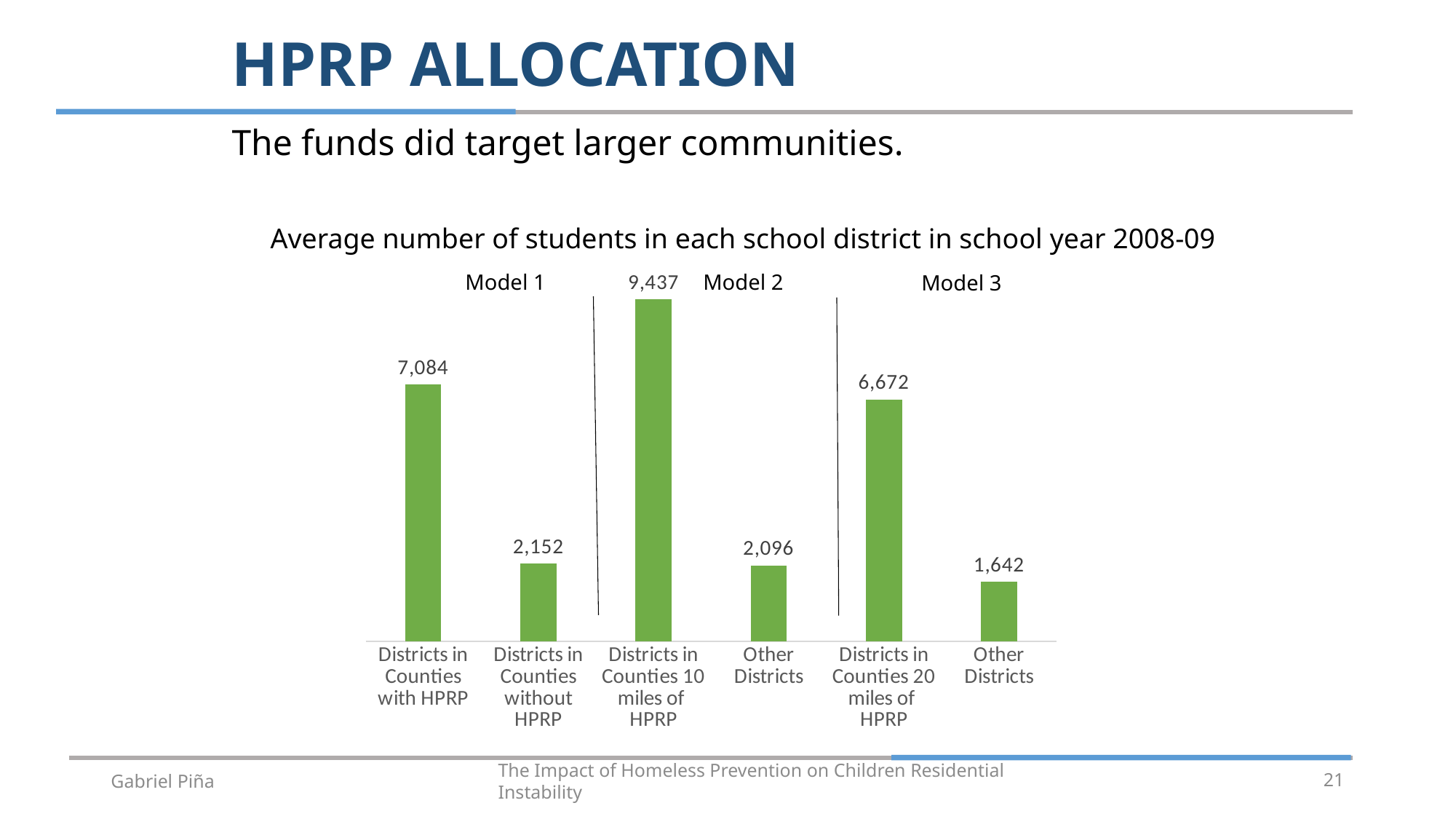
How many bars are shown in the chart? 6 Which category has the highest average number of students? Districts in Counties 10 miles of HPRP What is the average number of students for Districts in Counties 20 miles of HPRP? 6,672 Which category has the lowest average number of students? Other Districts (Model 3) What type of chart is shown on the slide? Bar chart What is the value for Other Districts in Model 3? 1,642 Which is larger: Districts in Counties without HPRP or Other Districts in Model 2? Districts in Counties without HPRP What is the difference between Districts in Counties with HPRP and Districts in Counties without HPRP? 4,932 What is the difference between Districts in Counties 10 miles of HPRP and Other Districts in Model 2? 7,341 What is the title of the chart? Average number of students in each school district in school year 2008-09 What is the average number of students for Districts in Counties 10 miles of HPRP? 9,437 What is the average number of students for Districts in Counties with HPRP? 7,084